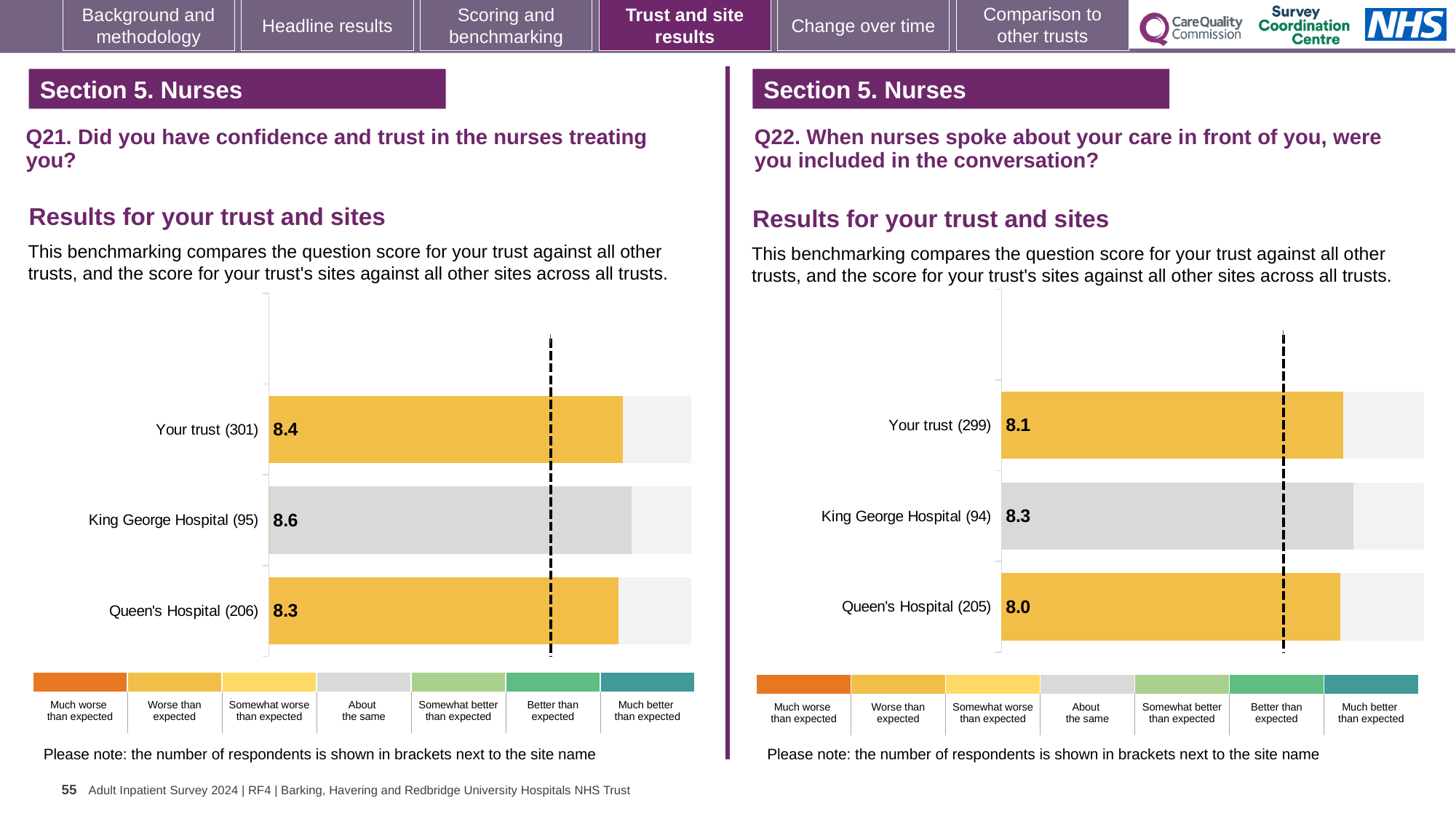
In the Q22 chart on the right, which has the higher score, Your trust or King George Hospital? King George Hospital In the Q22 chart on the right, what is the difference between the scores for Your trust and Queen's Hospital? 0.1 In the Q22 chart on the right, what is the score for Queen's Hospital? 8.0 In the Q21 chart on the left, which site or trust has the highest score? King George Hospital In the Q21 chart on the left, what is the score for Your trust? 8.4 In the Q22 chart on the right, what is the score for King George Hospital? 8.3 How many bars are plotted in the Q21 chart on the left? 3 In the Q21 chart on the left, what is the score for King George Hospital? 8.6 In the Q22 chart on the right, which site or trust has the lowest score? Queen's Hospital In the Q21 chart on the left, what is the difference between the scores for King George Hospital and Queen's Hospital? 0.3 In the Q21 chart on the left, how many respondents are shown in brackets for Queen's Hospital? 206 What kind of chart is used for the Q22 results on the right? Bar chart